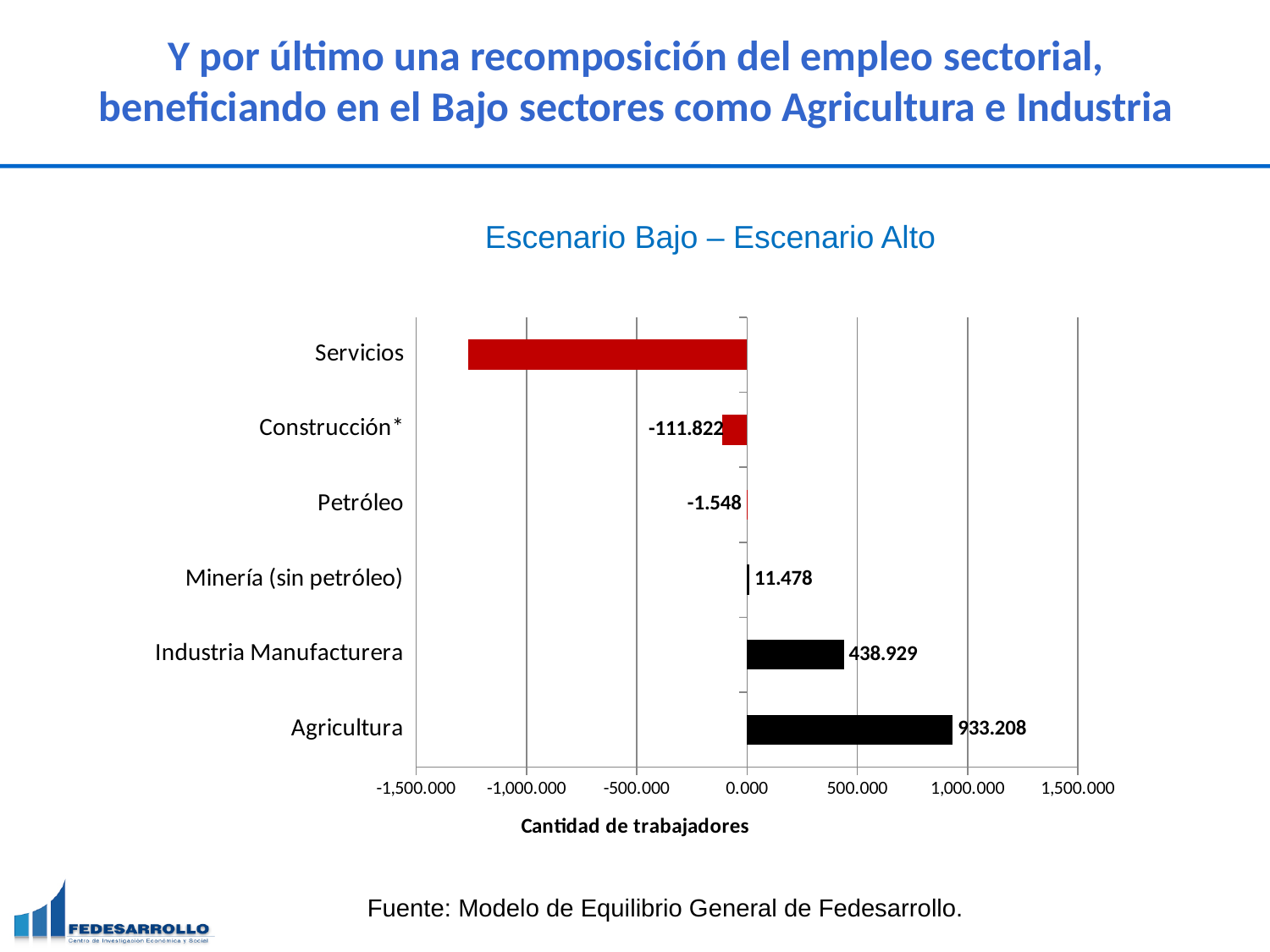
What is the value for Agricultura? 933.208 Which is larger, the value for Construcción* or the value for Petróleo? Petróleo What is the difference between the values for Agricultura and Industria Manufacturera? 494.279 Which sector has the lowest value? Servicios What is the value for Industria Manufacturera? 438.929 How many sectors are shown in the chart? 6 Which sector has the highest value? Agricultura Is the value for Servicios greater or less than -1,000.000? less What is the value for Petróleo? -1.548 What kind of chart is shown on the slide? Bar chart What is the value for Minería (sin petróleo)? 11.478 What is the value for Construcción*? -111.822